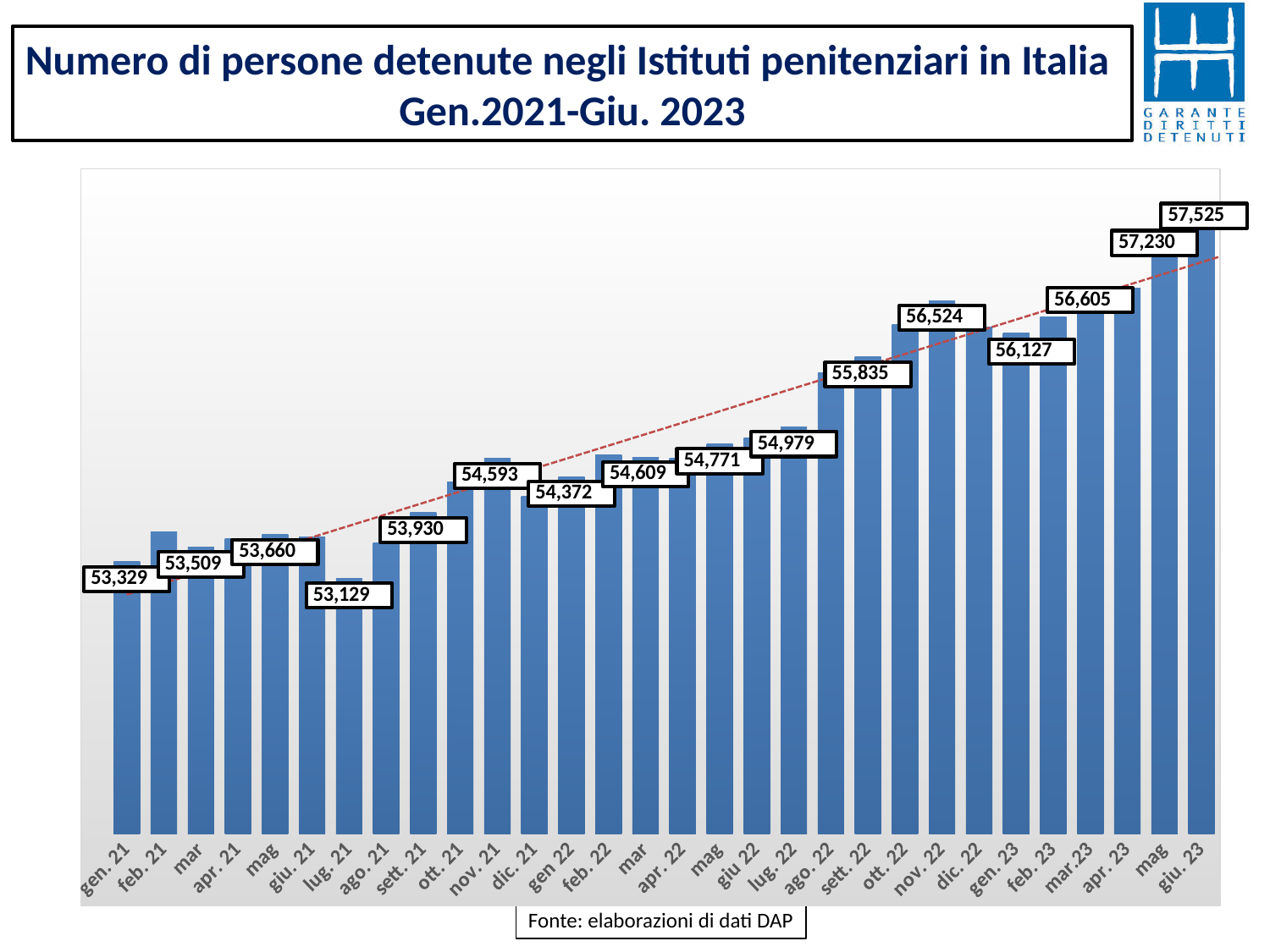
How many monthly bars are plotted in the chart? 30 What is the difference between the values for giu. 23 and gen. 21? 4,196 What is the number of detained persons shown for gen. 21? 53,329 What is the title of the chart? Numero di persone detenute negli Istituti penitenziari in Italia Gen.2021-Giu. 2023 Which month has the highest number of detained persons? giu. 23 Do the values generally rise or fall from gen. 21 to giu. 23? Rise What kind of chart is shown on the slide? Bar chart What source is cited below the chart? Fonte: elaborazioni di dati DAP Which month has the lowest number of detained persons? lug. 21 What is the value labelled on the lowest bar, lug. 21? 53,129 Which is larger, the value for gen. 21 or the value for lug. 21? gen. 21 What is the number of detained persons shown for giu. 23? 57,525